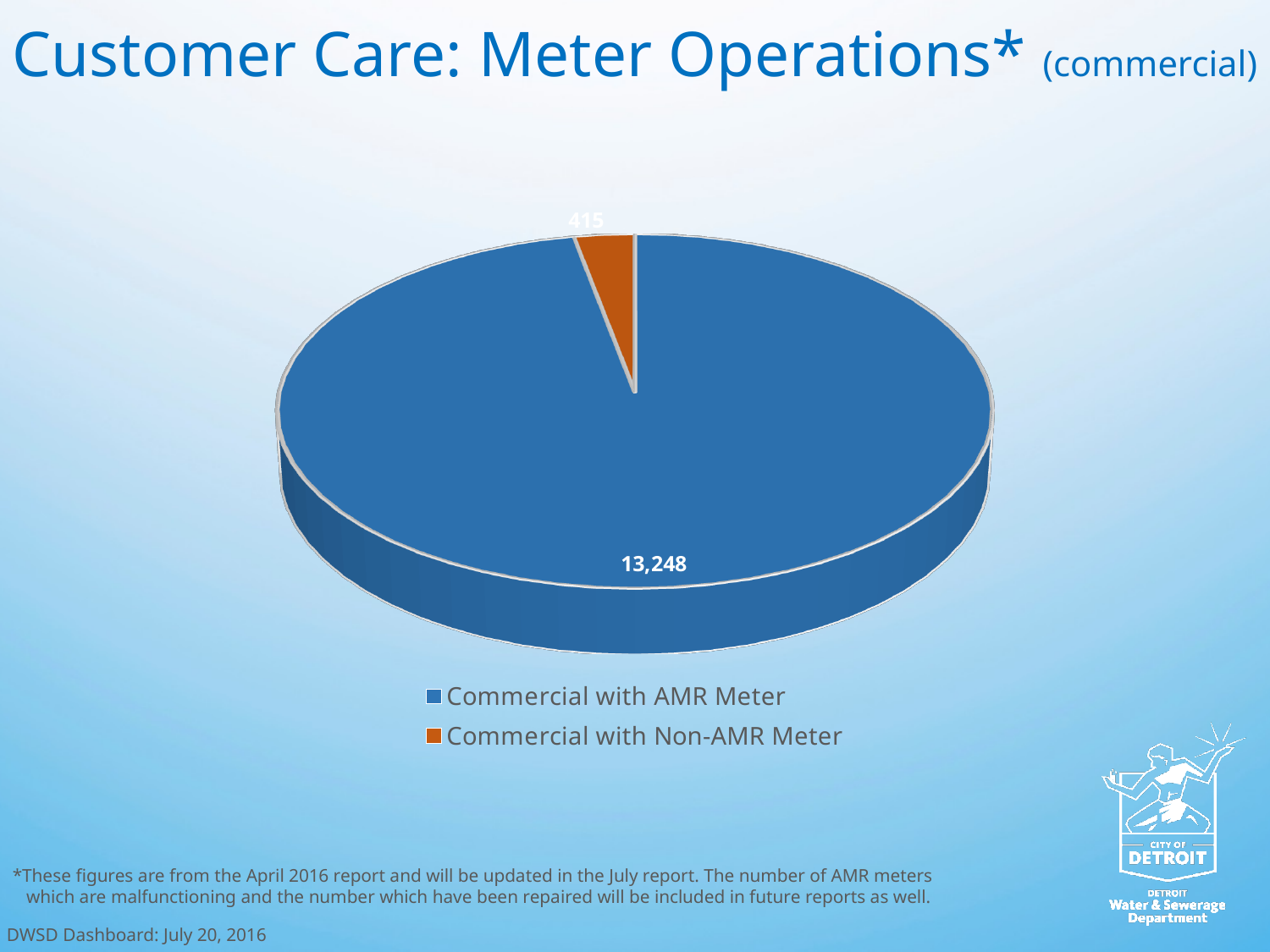
How many commercial customers have a Non-AMR meter according to the pie chart? 415 How many commercial customers have an AMR meter according to the pie chart? 13,248 Which category has the largest slice of the pie chart? Commercial with AMR Meter Which category has the smallest slice of the pie chart? Commercial with Non-AMR Meter How many slices does the pie chart have? 2 What is the title of the slide containing the pie chart? Customer Care: Meter Operations* (commercial) Which is larger: the number of commercial customers with an AMR meter or with a Non-AMR meter? Commercial with AMR Meter How many entries does the legend list? 2 What colour is the slice for Commercial with Non-AMR Meter? Orange What kind of chart is shown on the slide? Pie chart What is the total number of commercial customers represented in the pie chart? 13,663 What is the difference between the number of commercial customers with an AMR meter and those with a Non-AMR meter? 12,833